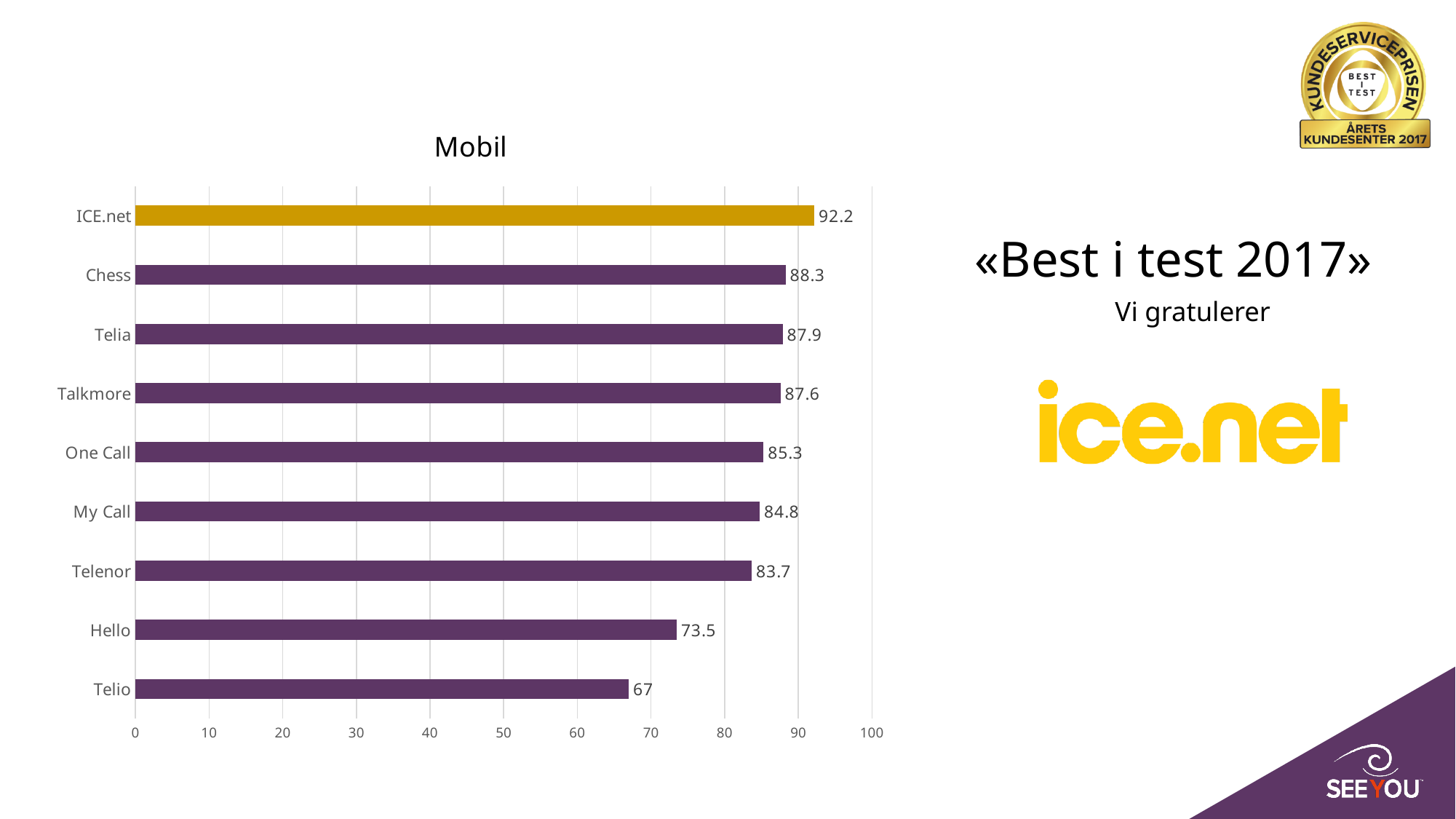
How many categories are shown in the chart? 9 What is the difference between the values for ICE.net and Chess? 3.9 Which category has the highest value? ICE.net What is the title of the chart? Mobil What is the value for Hello? 73.5 Which category has the lowest value? Telio Which is larger, the value for One Call or the value for Telenor? One Call What is the value for ICE.net? 92.2 Is the value for Telio greater or less than 70? less What is the difference between the values for Hello and Telio? 6.5 What is the value for Telenor? 83.7 What kind of chart is shown on the slide? bar chart